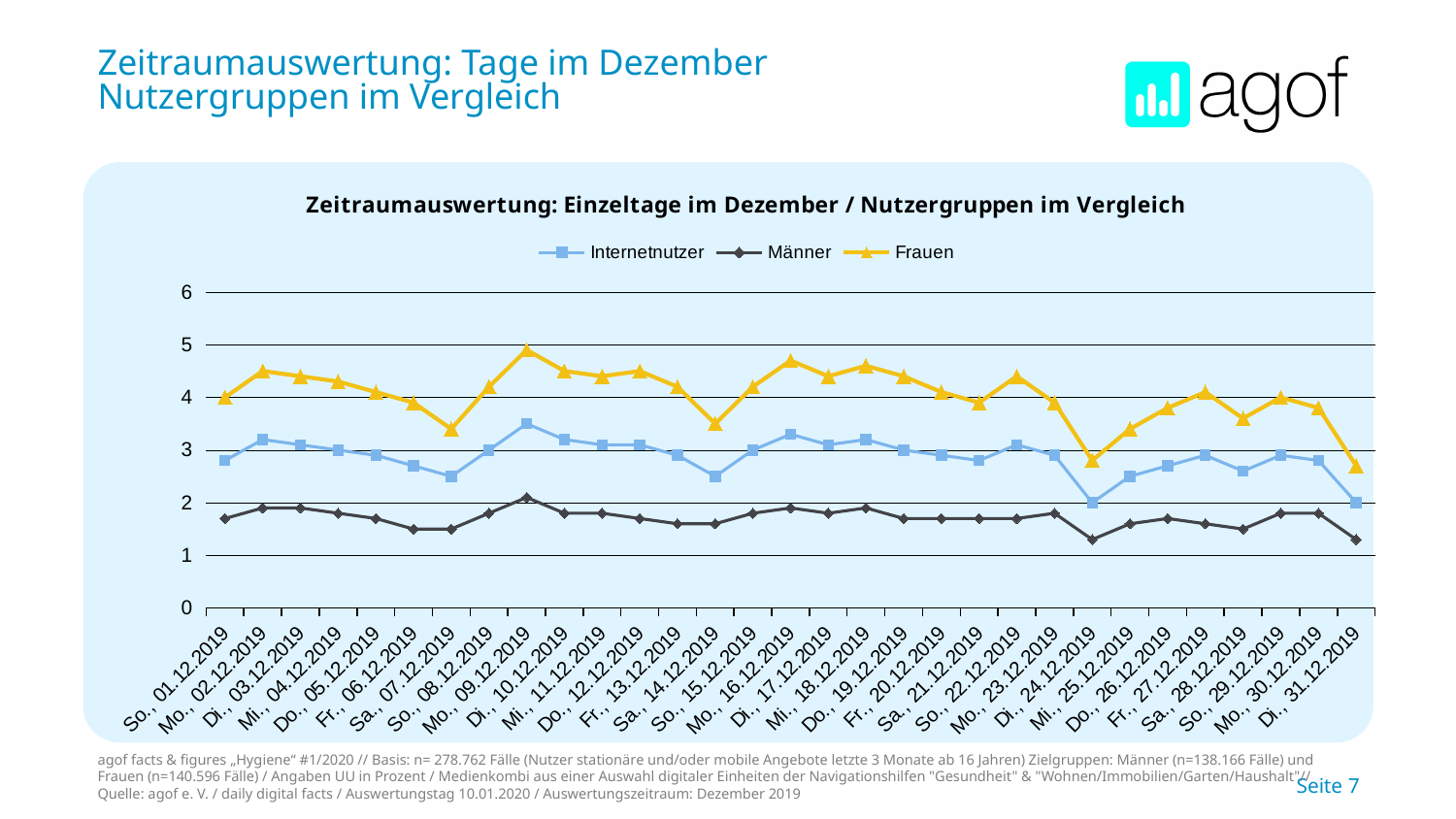
Is the value for Internetnutzer on Mi., 25.12.2019 greater or less than 3? less On which day does the Internetnutzer series reach its highest value? Mo., 09.12.2019 Is the value for Frauen on Di., 10.12.2019 greater or less than 4? greater Which is larger on Sa., 07.12.2019: the value for Frauen or the value for Männer? Frauen On which day does the Frauen series reach its highest value? Mo., 09.12.2019 Is the value for Männer on Mi., 25.12.2019 greater or less than 2? less How many series does the legend list? 3 How many days are plotted along the x axis? 31 What kind of chart is shown on the slide? line chart What is the title of the chart? Zeitraumauswertung: Einzeltage im Dezember / Nutzergruppen im Vergleich Which series has the highest values across all days? Frauen Do the values of all three series rise or fall from Di., 24.12.2019 to Mi., 25.12.2019? rise